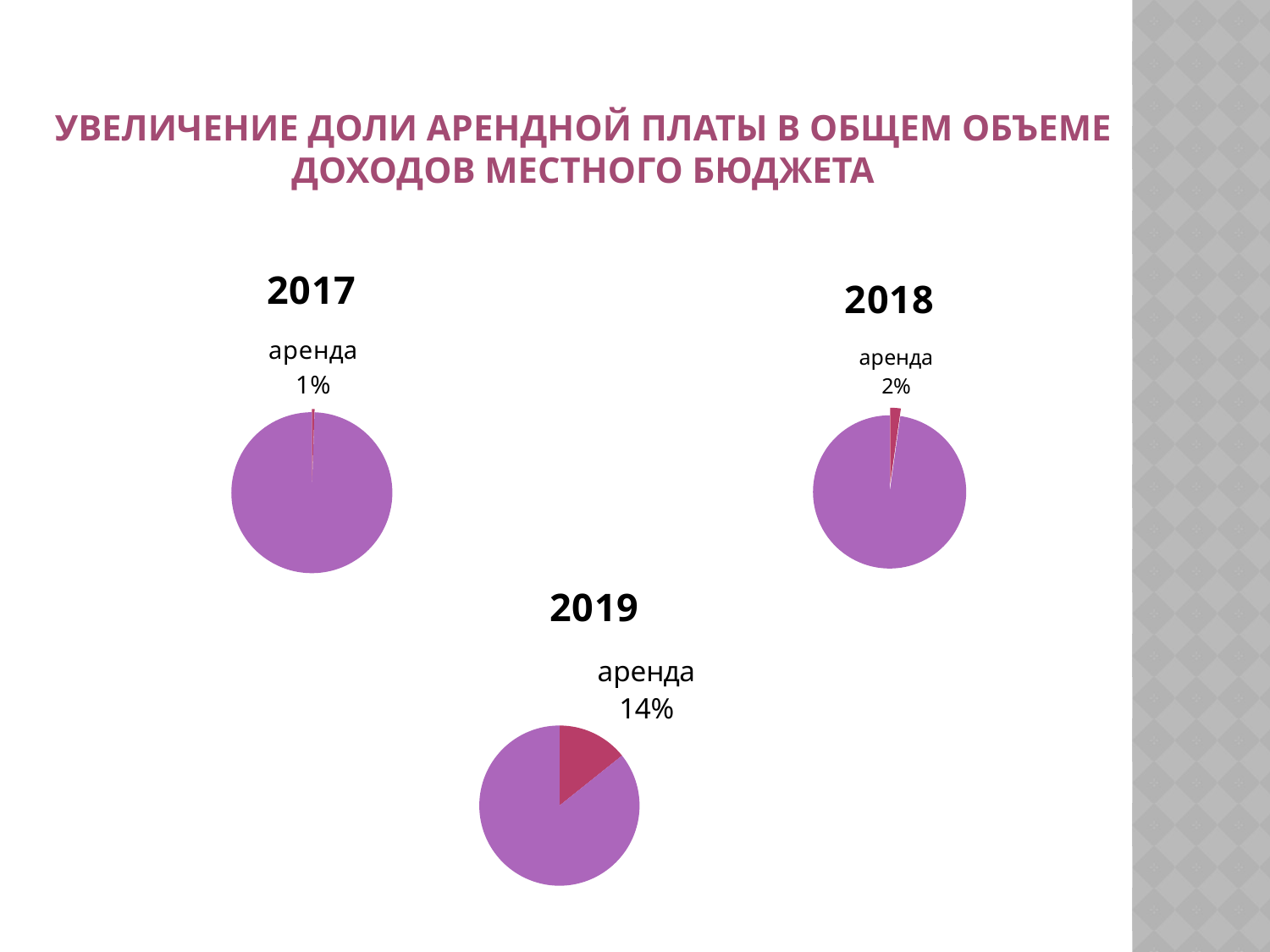
How many pie charts are shown on the slide? 3 In the pie chart titled 2017, what share is labelled for аренда? 1% In the pie chart titled 2019, what share is labelled for аренда? 14% Is the аренда share larger in the 2018 pie chart or in the 2019 pie chart? 2019 In the pie chart titled 2018, what share is labelled for аренда? 2% By how many percentage points does the аренда share in the 2018 pie chart exceed the аренда share in the 2017 pie chart? 1 percentage point What is the title of the 2019 pie chart on the slide? 2019 By how many percentage points does the аренда share in the 2019 pie chart exceed the аренда share in the 2017 pie chart? 13 percentage points Does the аренда share rise or fall from the 2017 chart to the 2019 chart? Rise Across the three pie charts, which year shows the smallest share for аренда? 2017 What kind of chart is used for the 2019 chart on the slide? Pie chart Across the three pie charts, which year shows the largest share for аренда? 2019